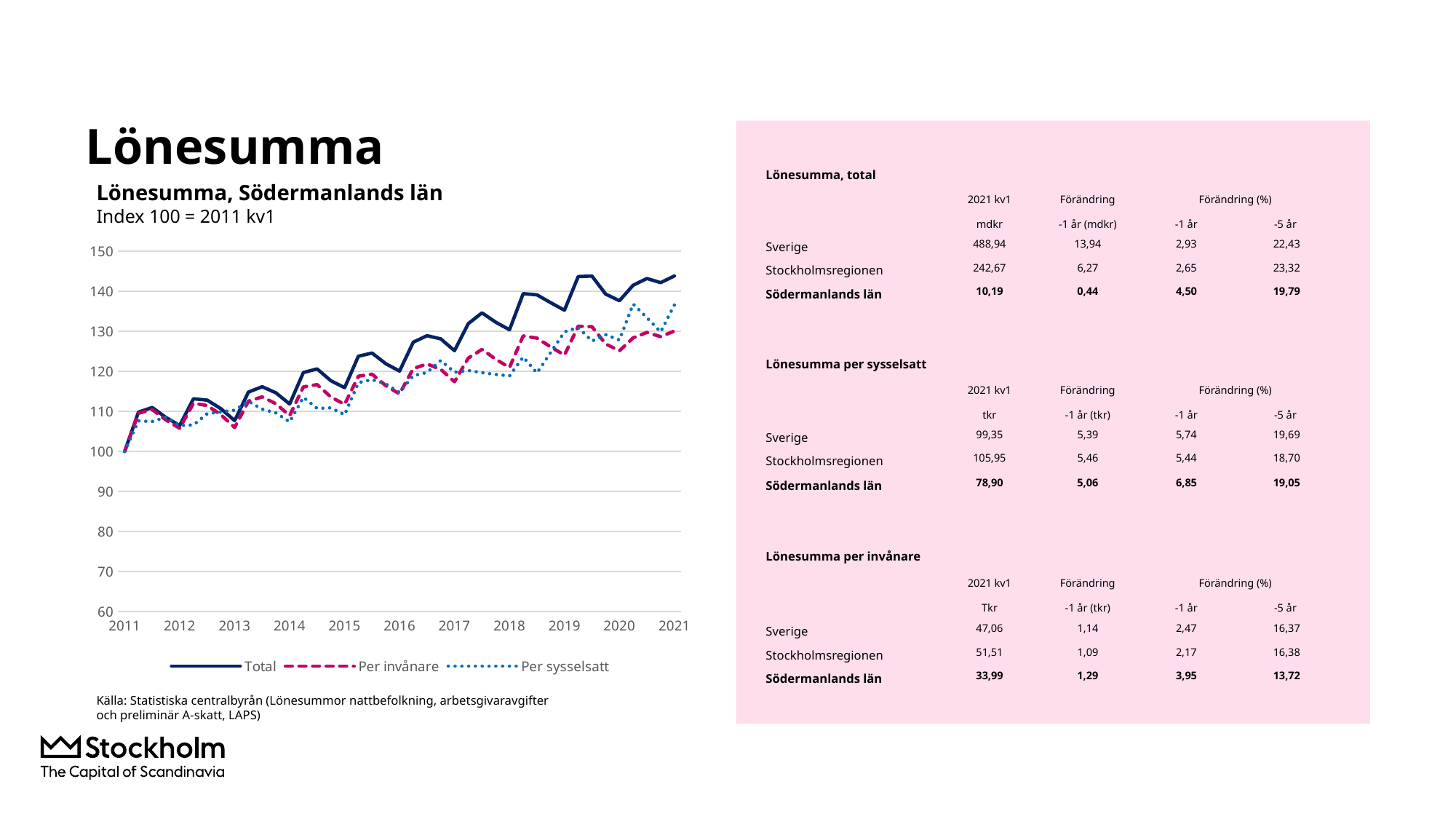
Is the value for Per invånare at 2021 greater or less than 140? less What is the index value of the series at the start of the chart in 2011? 100 Which series has the lowest value at 2021? Per invånare Does the Total series generally rise or fall from 2011 to 2021? Rise What kind of chart is shown on the slide? Line chart Which series has the highest value at 2021? Total How many series does the chart legend list? 3 Is the value for Per sysselsatt at 2016 greater or less than 120? less Is the value for Total at 2021 greater or less than 140? greater Which series are listed in the chart legend? Total, Per invånare, Per sysselsatt What is the title of the chart? Lönesumma, Södermanlands län At 2021, which is larger: the Total series or the Per invånare series? Total